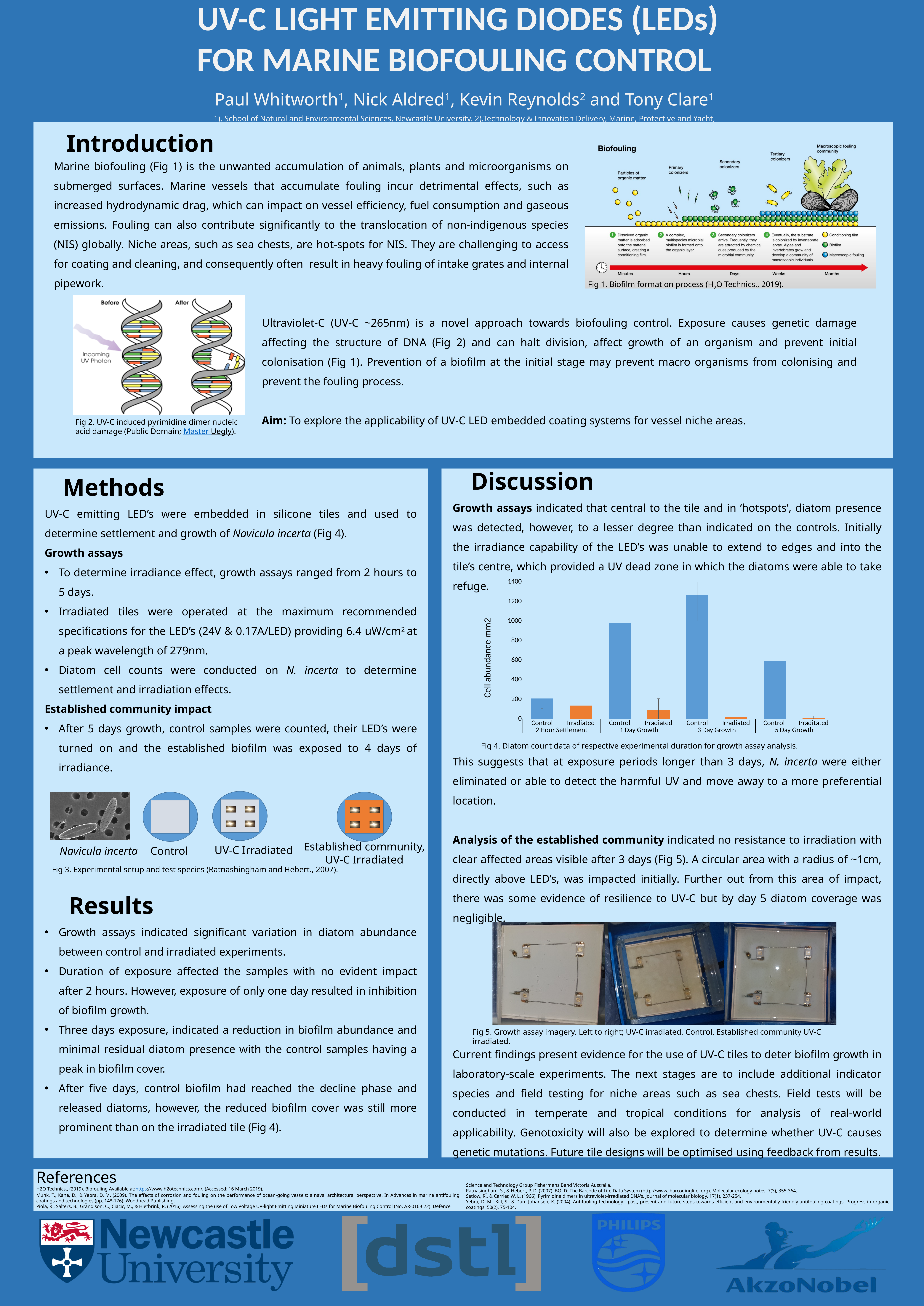
How many bars are plotted in the Fig 4 chart? 8 In Fig 4, is the value for Control at 5 Day Growth greater or less than 800? less In Fig 4, which is larger: Control at 1 Day Growth or Control at 5 Day Growth? Control at 1 Day Growth In Fig 4, does the Control value rise or fall from 3 Day Growth to 5 Day Growth? fall What is the y-axis label of the Fig 4 chart? Cell abundance mm2 In Fig 4, is the value for Irradiated at 2 Hour Settlement greater or less than 200? less In Fig 4, is the value for Control at 1 Day Growth greater or less than 800? greater In Fig 4, which bar has the highest cell abundance? Control, 3 Day Growth In Fig 4, which is larger: Irradiated at 2 Hour Settlement or Irradiated at 3 Day Growth? Irradiated at 2 Hour Settlement What kind of chart is Fig 4 on the slide? bar chart